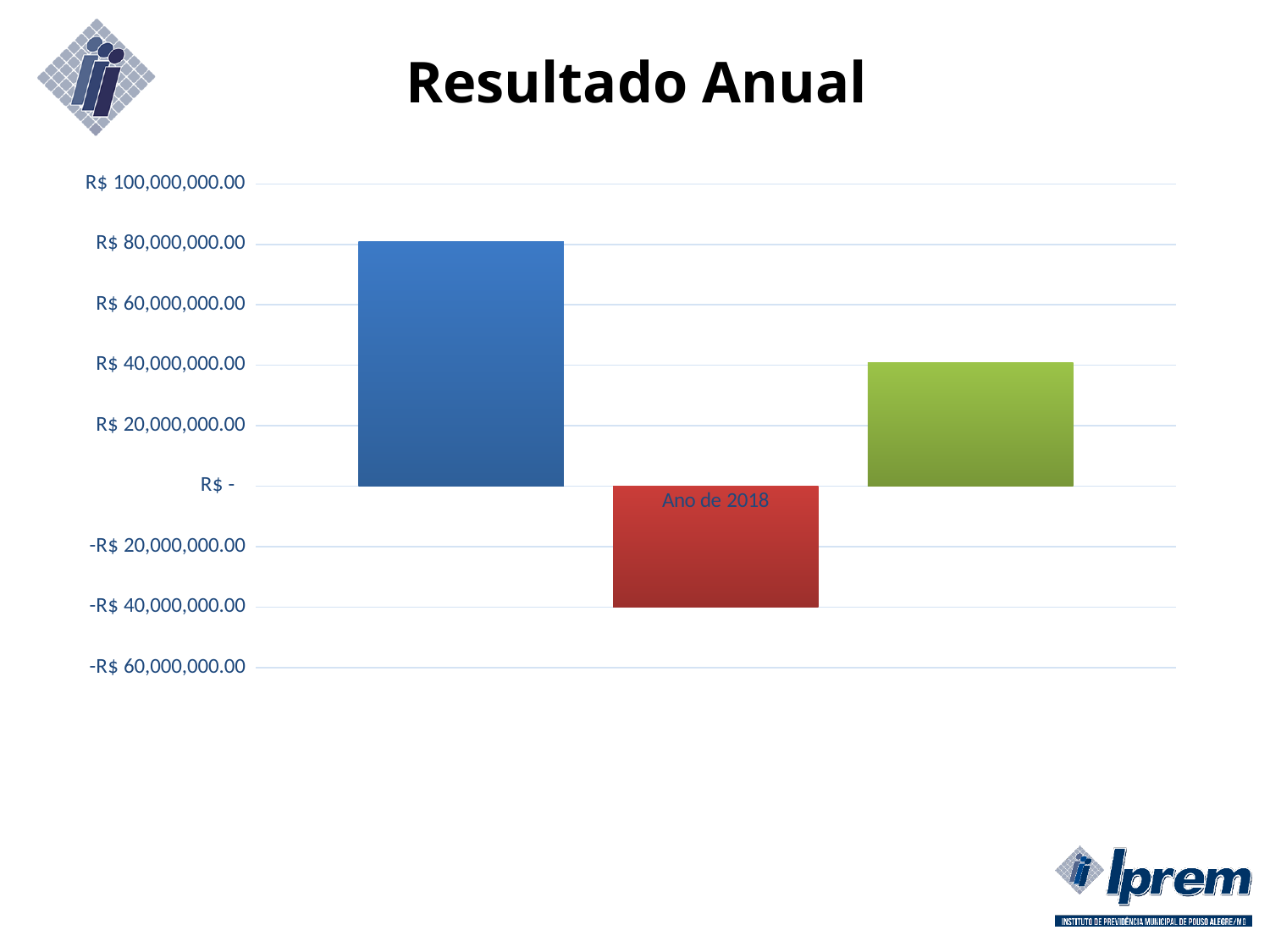
Which bar has the larger value: the green bar or the red bar? green How many bars are plotted in the chart? 3 Is the value of the blue bar greater or less than R$ 60,000,000.00? greater Is the value of the red bar greater or less than -R$ 20,000,000.00? less What is the title of the chart? Resultado Anual What category label is printed on the x axis of the chart? Ano de 2018 Which bar has the larger value: the blue bar or the green bar? blue What kind of chart is shown on the slide? bar chart Which bar is the tallest (highest value) in the chart: the blue, red or green one? blue Is the value of the green bar greater or less than R$ 60,000,000.00? less Which bar has the lowest value in the chart: the blue, red or green one? red